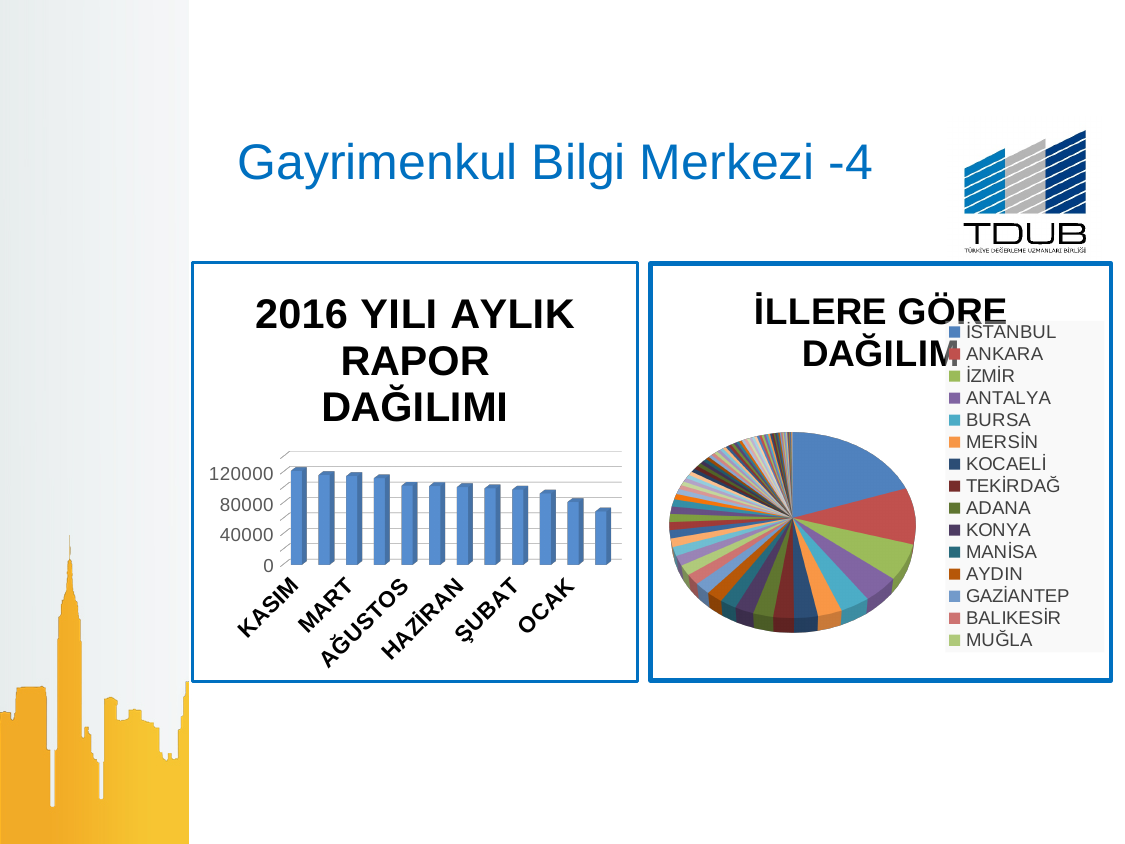
In the 'İLLERE GÖRE DAĞILIMI' pie chart, which province has the largest slice? İSTANBUL In the '2016 YILI AYLIK RAPOR DAĞILIMI' chart, which is larger, the value for KASIM or the value for ŞUBAT? KASIM In the '2016 YILI AYLIK RAPOR DAĞILIMI' chart, which month has the highest bar? KASIM What kind of chart is the '2016 YILI AYLIK RAPOR DAĞILIMI' chart on the left? bar chart In the '2016 YILI AYLIK RAPOR DAĞILIMI' chart, what is the highest value shown on the vertical axis? 120000 In the '2016 YILI AYLIK RAPOR DAĞILIMI' chart, is the value for KASIM greater or less than 80000? greater In the '2016 YILI AYLIK RAPOR DAĞILIMI' chart, do the bar values rise or fall from left to right? fall What kind of chart is the 'İLLERE GÖRE DAĞILIMI' chart on the right? pie chart How many entries are listed in the legend of the 'İLLERE GÖRE DAĞILIMI' pie chart? 15 In the 'İLLERE GÖRE DAĞILIMI' pie chart, which slice is larger, İSTANBUL or ANKARA? İSTANBUL